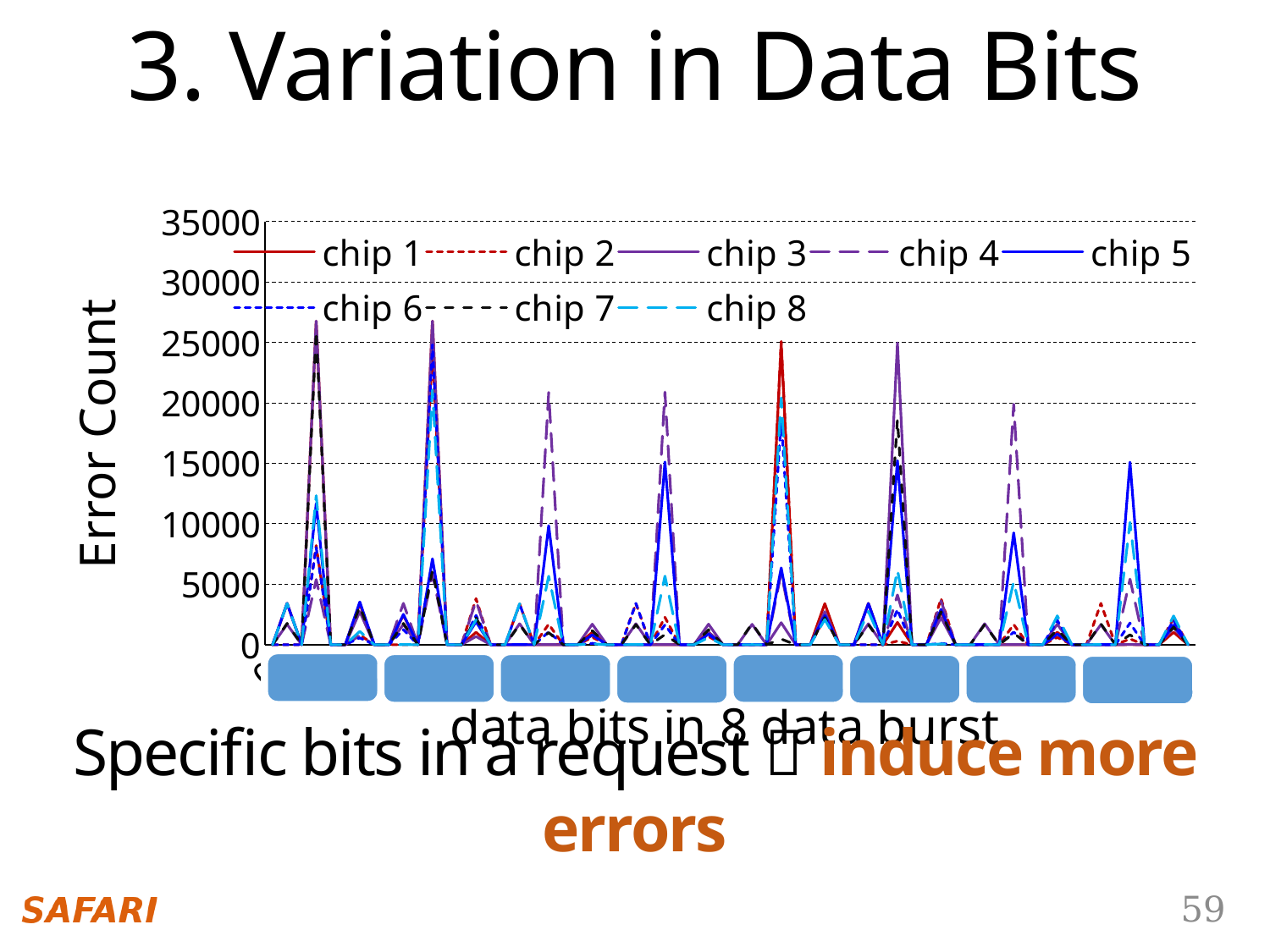
What kind of chart is shown on the slide? line chart Is the highest peak on the chart greater or less than 30000? less What is the label of the x axis? data bits in 8 data burst What is the interval between consecutive y-axis ticks? 5000 What is the highest tick value shown on the y axis? 35000 What is the name of the last series in the legend? chip 8 What is the label of the y axis? Error Count How many series does the legend list? 8 What is the name of the first series in the legend? chip 1 Is the highest peak on the chart greater or less than 20000? greater How many blue boxes are drawn beneath the x axis? 8